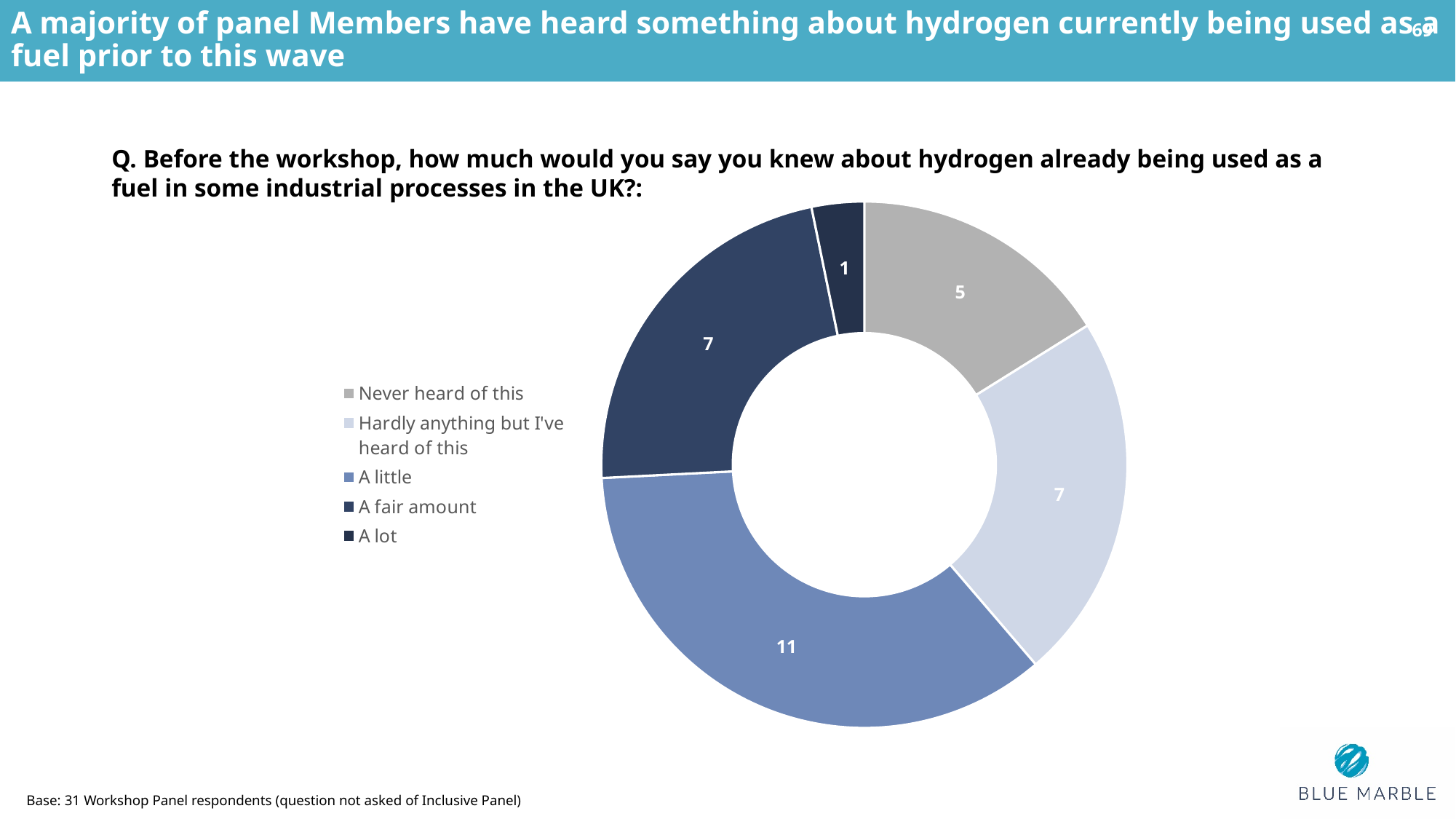
How many categories does the legend list? 5 How many respondents said 'A little'? 11 Which category has the smallest number of respondents? A lot How many respondents said 'A lot'? 1 Which is larger: the number who said 'Never heard of this' or the number who said 'A fair amount'? A fair amount How many respondents said 'A fair amount'? 7 Which legend entry is shown in grey? Never heard of this What is the total number of respondents across all segments of the chart? 31 What kind of chart is shown on the slide? Doughnut chart What is the difference between the number of respondents who said 'A little' and those who said 'Never heard of this'? 6 Which category has the largest number of respondents? A little How many respondents said 'Never heard of this'? 5